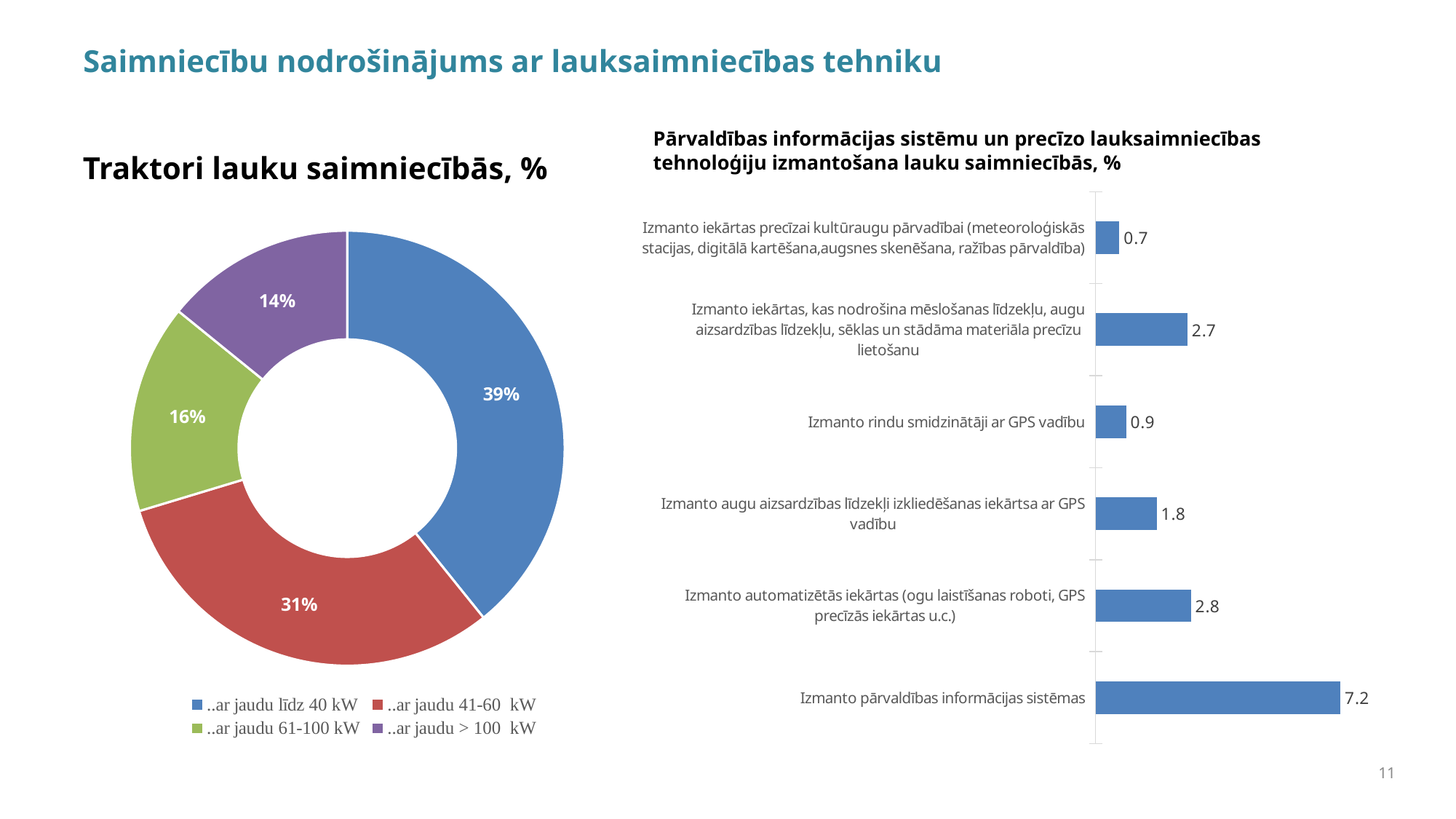
In the chart titled "Traktori lauku saimniecībās, %", which category has the largest share? ..ar jaudu līdz 40 kW In the chart titled "Traktori lauku saimniecībās, %", what share is shown for "..ar jaudu 61-100 kW"? 16% In the bar chart on the right, what is the value for "Izmanto rindu smidzinātāji ar GPS vadību"? 0.9 In the chart titled "Traktori lauku saimniecībās, %", what is the difference between the shares for "..ar jaudu līdz 40 kW" and "..ar jaudu 41-60 kW"? 8% In the bar chart on the right, which category has the lowest value? Izmanto iekārtas precīzai kultūraugu pārvadībai (meteoroloģiskās stacijas, digitālā kartēšana, augsnes skenēšana, ražības pārvaldība) In the chart titled "Traktori lauku saimniecībās, %", how many categories does the legend list? 4 In the chart titled "Traktori lauku saimniecībās, %", what share is shown for "..ar jaudu līdz 40 kW"? 39% In the bar chart on the right, what is the value for "Izmanto pārvaldības informācijas sistēmas"? 7.2 How many bars are shown in the bar chart on the right? 6 What kind of chart is the one titled "Traktori lauku saimniecībās, %"? Pie (doughnut) chart In the chart titled "Traktori lauku saimniecībās, %", which category has the smallest share? ..ar jaudu > 100 kW In the bar chart on the right, which is larger: the value for "Izmanto augu aizsardzības līdzekļi izkliedēšanas iekārtsa ar GPS vadību" or the value for "Izmanto automatizētās iekārtas (ogu laistīšanas roboti, GPS precīzās iekārtas u.c.)"? Izmanto automatizētās iekārtas (ogu laistīšanas roboti, GPS precīzās iekārtas u.c.)